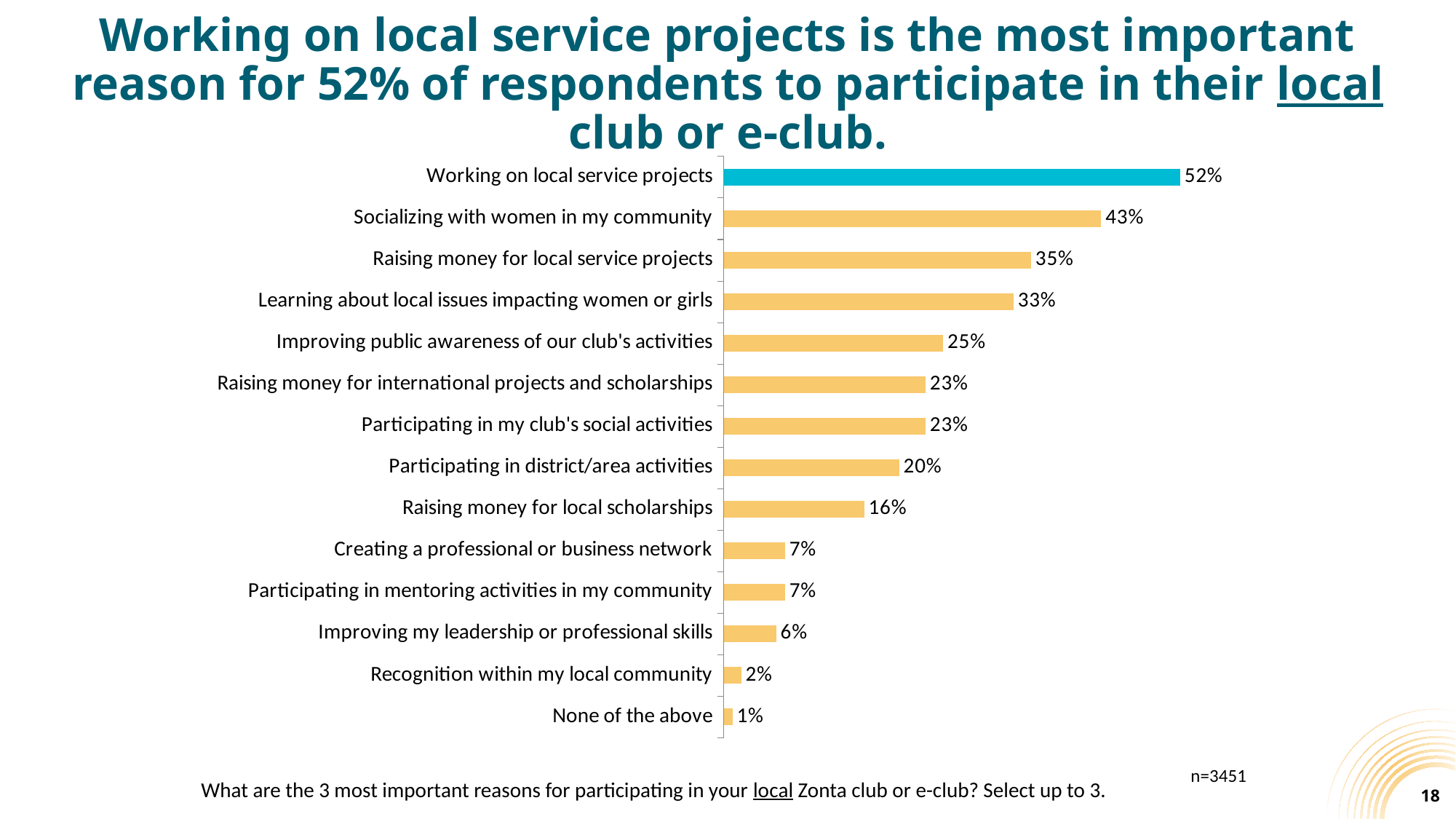
What percentage of respondents selected 'Working on local service projects'? 52% What is the value for 'Socializing with women in my community'? 43% What kind of chart is shown on the slide? Bar chart What is the difference between 'Working on local service projects' and 'Socializing with women in my community'? 9% Which category has the lowest value? None of the above Which bar is highlighted in a different colour (blue) from the others? Working on local service projects How many categories are shown in the chart? 14 What is the difference between 'Raising money for local service projects' and 'Improving public awareness of our club's activities'? 10% What is the value for 'Recognition within my local community'? 2% What percentage is shown for 'Raising money for local scholarships'? 16% Which category has the highest value? Working on local service projects Which is larger: 'Learning about local issues impacting women or girls' or 'Participating in district/area activities'? Learning about local issues impacting women or girls